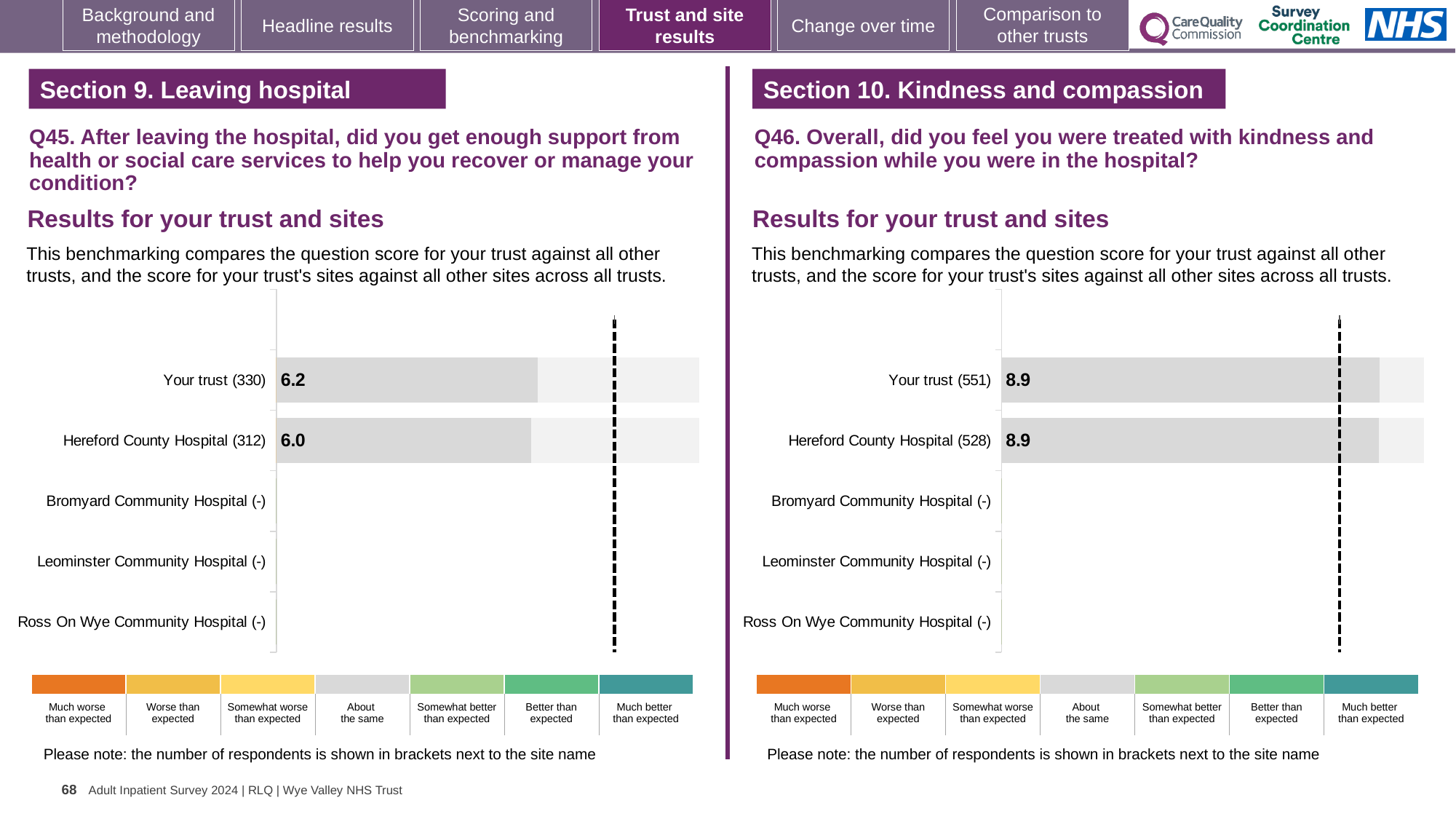
On the Q46 chart (right), how many respondents are shown in brackets for Hereford County Hospital? 528 On the Q45 chart (left), what is the difference between the score for Your trust and the score for Hereford County Hospital? 0.2 What kind of chart is used for the Q45 results on the left? Bar chart On the Q45 chart (left), what is the score for Your trust? 6.2 On the Q45 chart (left), what is the score for Hereford County Hospital? 6.0 How many site/trust categories are listed on the Q46 chart (right)? 5 On the Q45 chart (left), which has the higher score: Your trust or Hereford County Hospital? Your trust Which section heading appears above the Q46 chart on the right? Section 10. Kindness and compassion On the Q45 chart (left), how many sites show no score (marked with a dash)? 3 On the Q46 chart (right), what is the score for Your trust? 8.9 On the Q45 chart (left), how many respondents are shown in brackets for Your trust? 330 On the Q46 chart (right), what is the score for Hereford County Hospital? 8.9